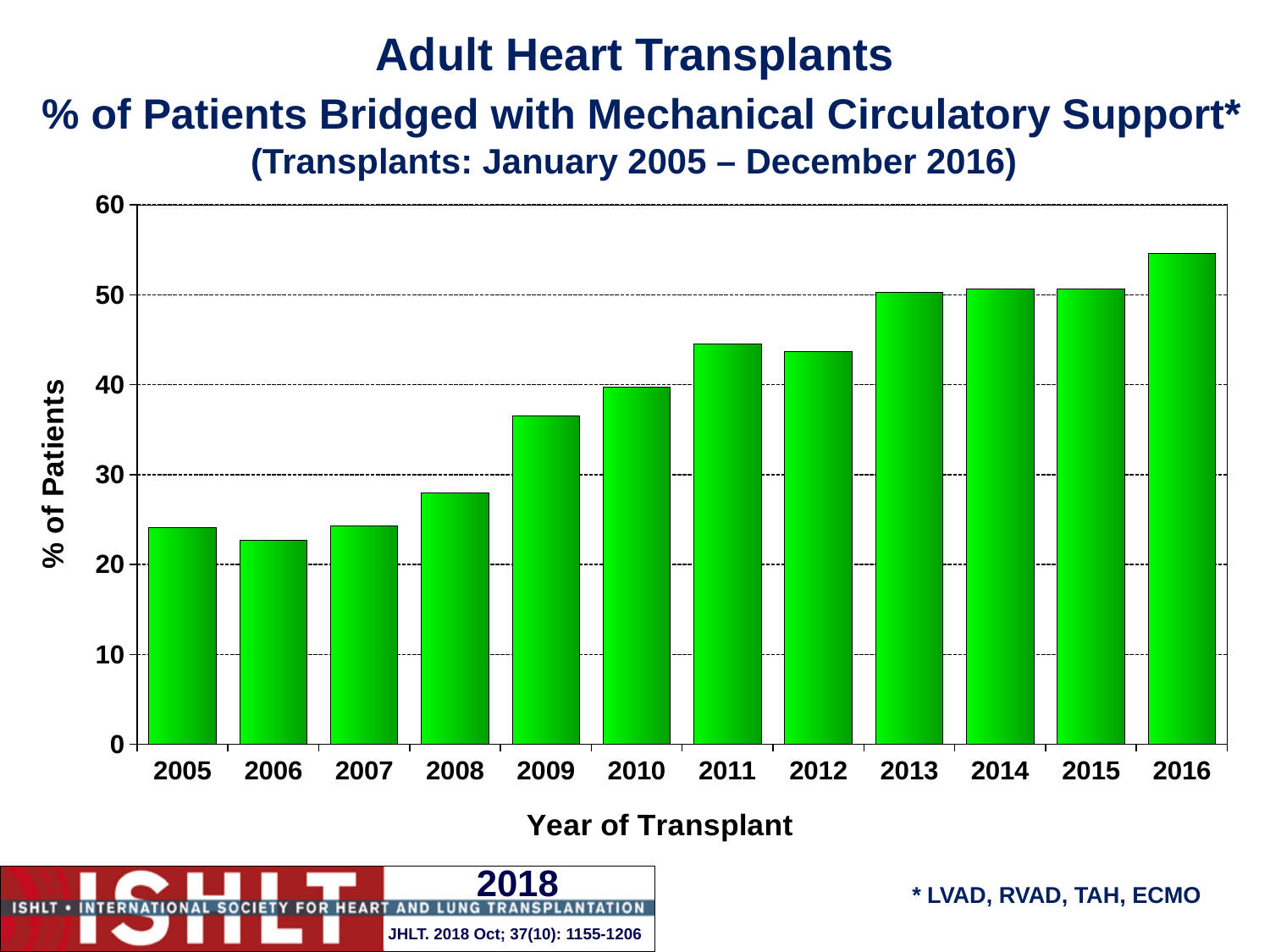
Is the value for 2012 greater or less than 40? greater Is the value for 2016 greater or less than 50? greater Is the value for 2005 greater or less than 30? less Which year has the lowest % of patients bridged with mechanical circulatory support? 2006 Which year has the larger value, 2008 or 2009? 2009 Which year has the larger value, 2009 or 2010? 2010 Which year has the highest % of patients bridged with mechanical circulatory support? 2016 What kind of chart is shown on the slide? Bar chart Overall, do the values rise or fall from 2005 to 2016? Rise How many years are plotted on the x axis? 12 What is the label of the y axis? % of Patients